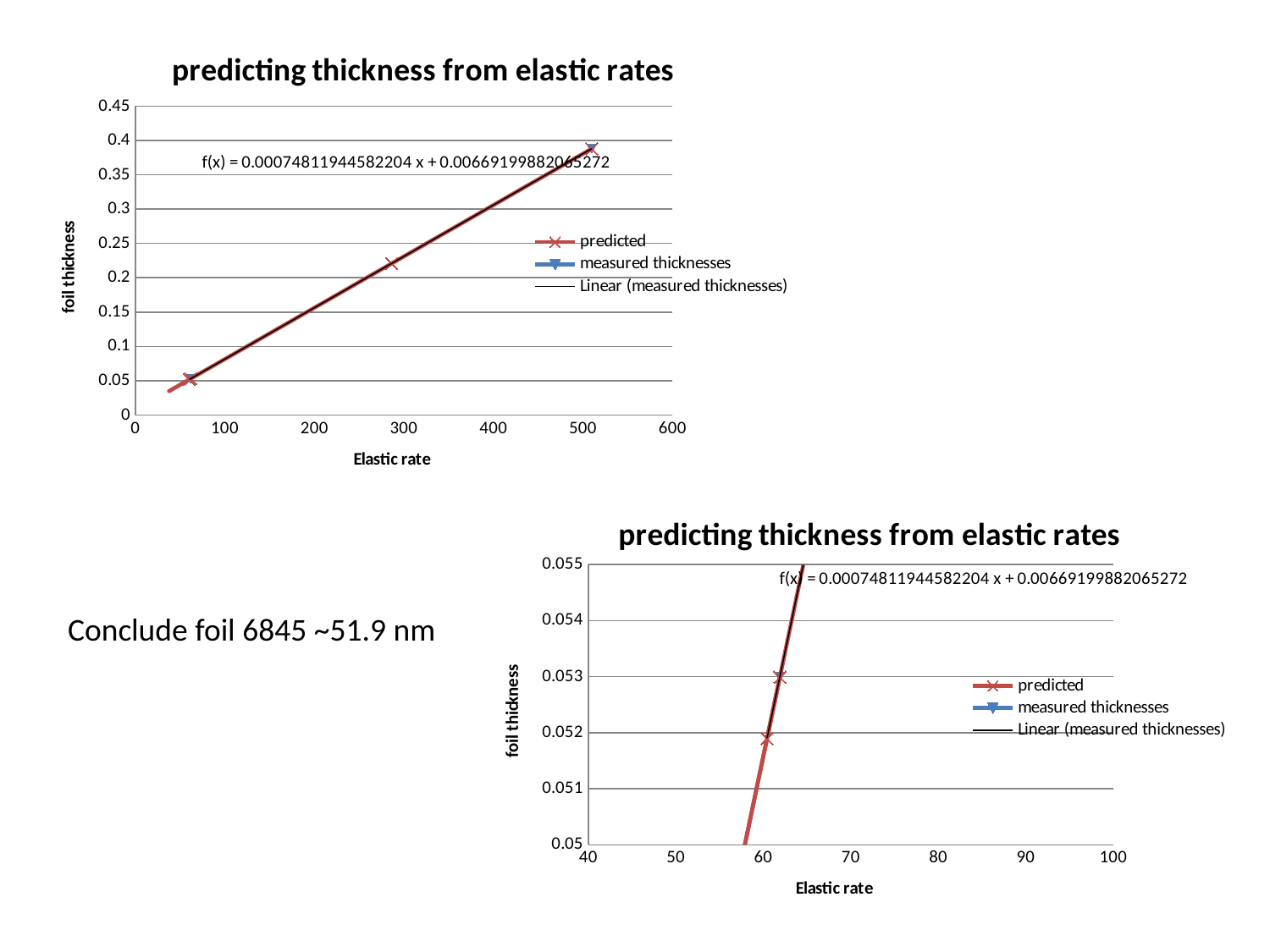
What is the title of the top-left chart? predicting thickness from elastic rates In the top-left chart, is the foil thickness at the highest plotted elastic rate (around 510) greater or less than 0.35? greater How many series does the legend of the bottom-right chart list? 3 In the bottom-right chart, is the foil thickness at the upper plotted point (elastic rate around 62) greater or less than 0.052? greater What is the label of the x axis on the bottom-right chart? Elastic rate In the top-left chart, how many data points are plotted for the predicted series? 4 In the top-left chart, is the foil thickness at the lowest plotted elastic rate (around 60) greater or less than 0.1? less In the top-left chart, does foil thickness rise or fall as elastic rate increases? rise In the bottom-right chart, does foil thickness rise or fall as elastic rate increases? rise What kind of chart is the top-left chart? line chart How many series does the legend of the top-left chart list? 3